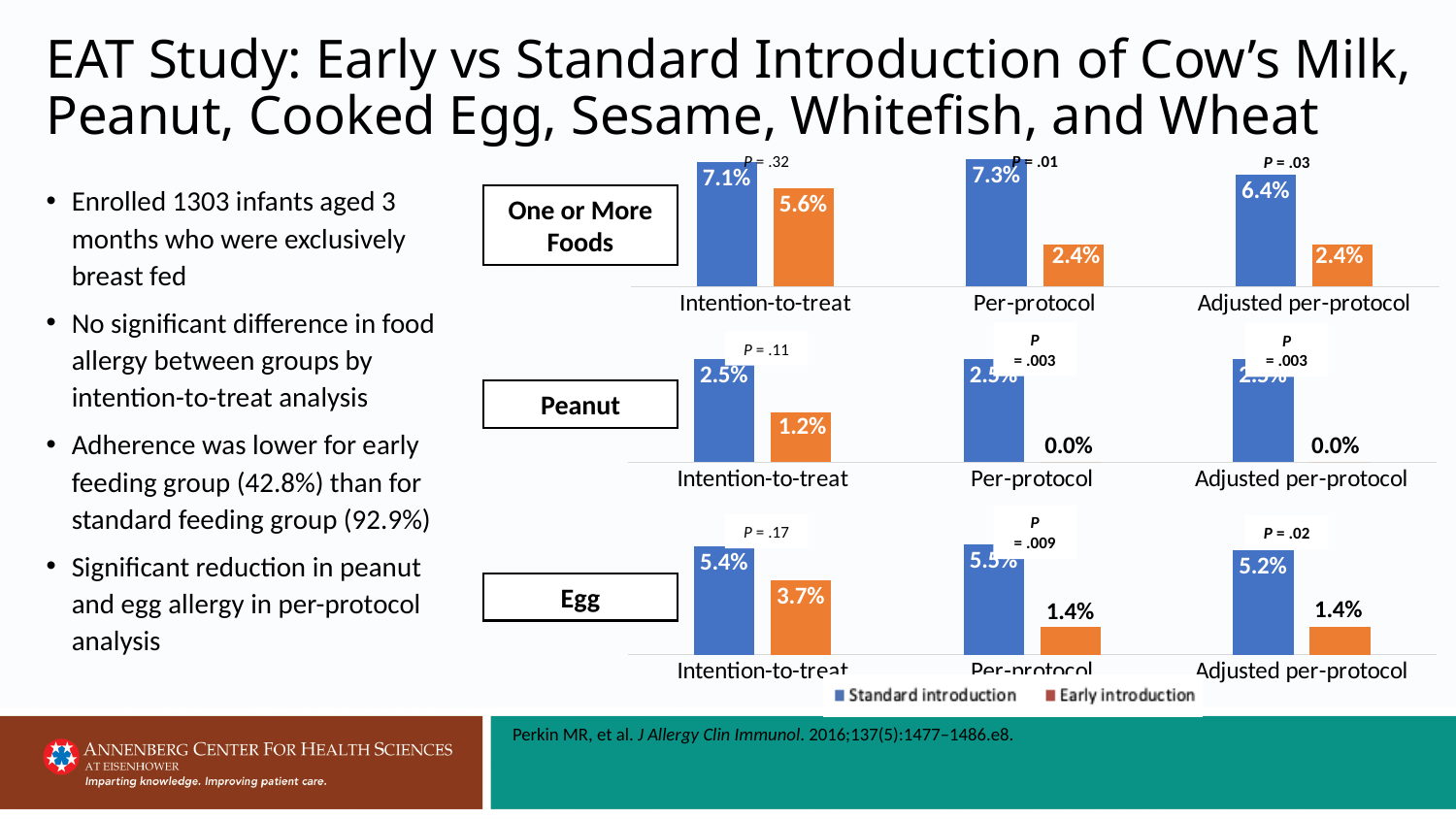
How many groups are shown on the x axis of the Peanut chart? 3 In the One or More Foods chart, which group has the highest Standard introduction value? Per-protocol In the Peanut chart, which series has the larger value in the Per-protocol group, Standard introduction or Early introduction? Standard introduction In the Egg chart, which group has the lowest Early introduction value? Per-protocol and Adjusted per-protocol (both 1.4%) In the One or More Foods chart, what is the value for Early introduction in the Per-protocol group? 2.4% What kind of chart is used for the Egg data? Bar chart In the Peanut chart, what is the value for Early introduction in the Intention-to-treat group? 1.2% In the One or More Foods chart, what is the value for Standard introduction in the Intention-to-treat group? 7.1% In the Egg chart, what is the value for Standard introduction in the Adjusted per-protocol group? 5.2% In the Egg chart, what is the difference between Standard introduction and Early introduction in the Per-protocol group? 4.1% How many series does the legend list? 2 In the One or More Foods chart, what is the difference between Standard introduction and Early introduction in the Intention-to-treat group? 1.5%